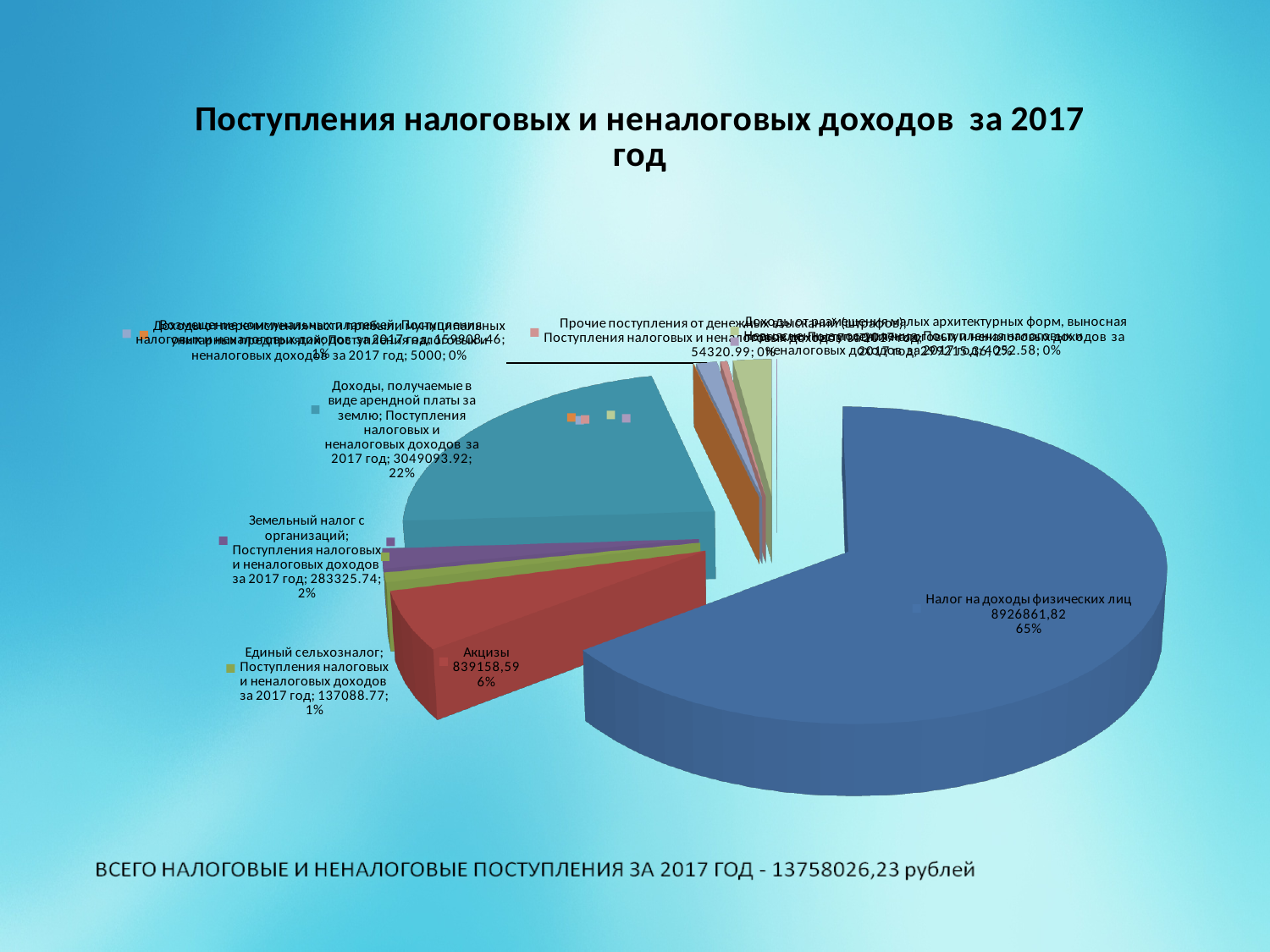
What kind of chart is shown on the slide? pie chart What share of the pie does Налог на доходы физических лиц represent? 65% What is the value shown for Налог на доходы физических лиц? 8926861,82 What is the value shown for Единый сельхозналог? 137088.77 Which category has the largest slice of the pie? Налог на доходы физических лиц What is the value shown for Земельный налог с организаций? 283325.74 What share of the pie does Акцизы represent? 6% What is the title of the chart? Поступления налоговых и неналоговых доходов за 2017 год What share of the pie do Доходы, получаемые в виде арендной платы за землю represent? 22% What is the value shown for Акцизы? 839158,59 What total amount of tax and non-tax revenue for 2017 is stated at the bottom of the slide? 13758026,23 рублей Which is larger, Акцизы or Земельный налог с организаций? Акцизы